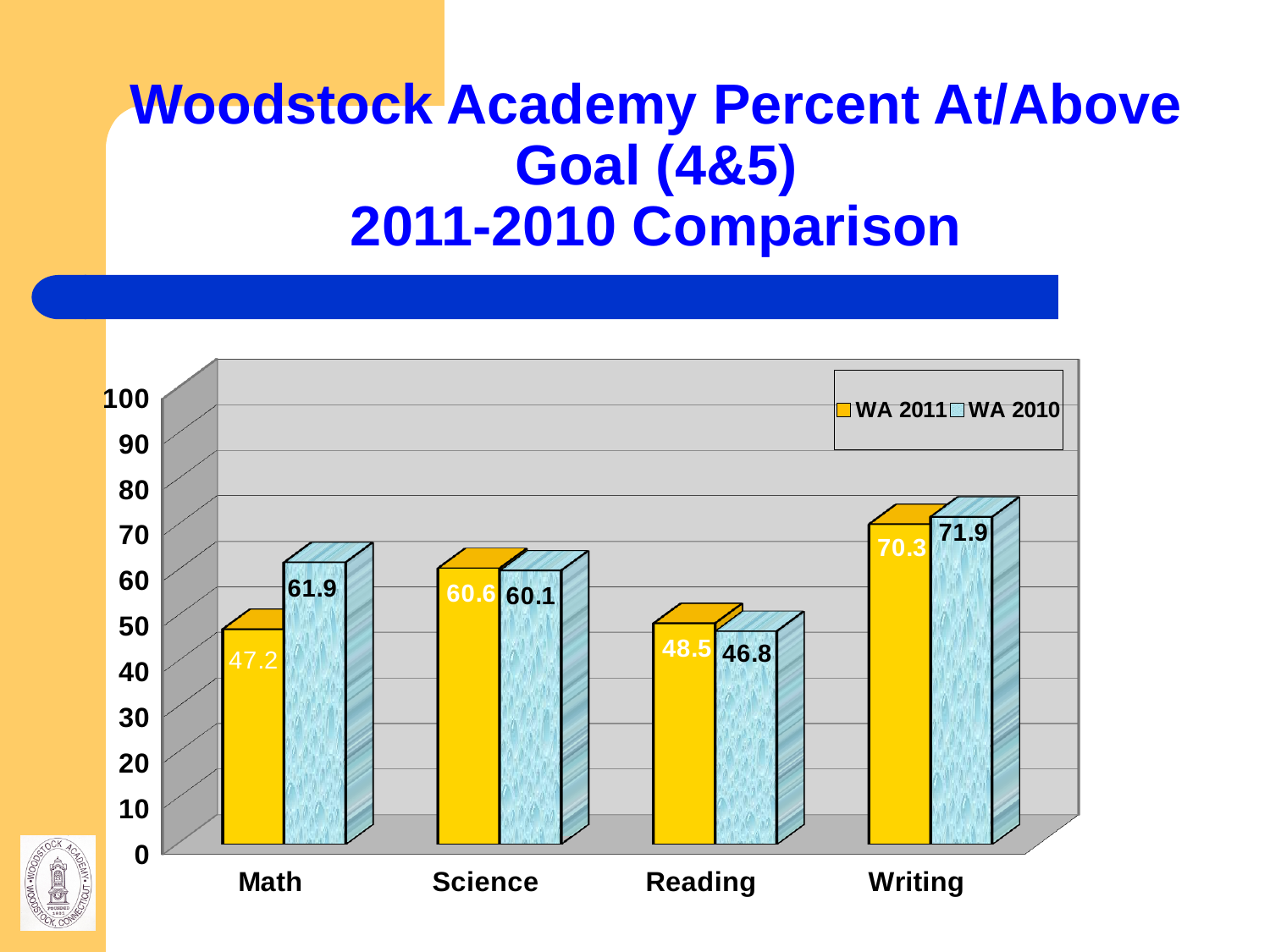
Is the WA 2011 value for Science greater or less than 50? greater Which subject has the lowest WA 2010 value? Reading What is the difference between the WA 2010 and WA 2011 values for Math? 14.7 What is the WA 2011 value for Math? 47.2 Which subject has the highest WA 2011 value? Writing What is the WA 2010 value for Reading? 46.8 How many subjects are shown on the x axis? 4 What is the WA 2010 value for Writing? 71.9 How many series does the legend list? 2 Which is larger for Reading, the WA 2011 value or the WA 2010 value? WA 2011 What kind of chart is shown on the slide? Bar chart Which series is shown in yellow? WA 2011